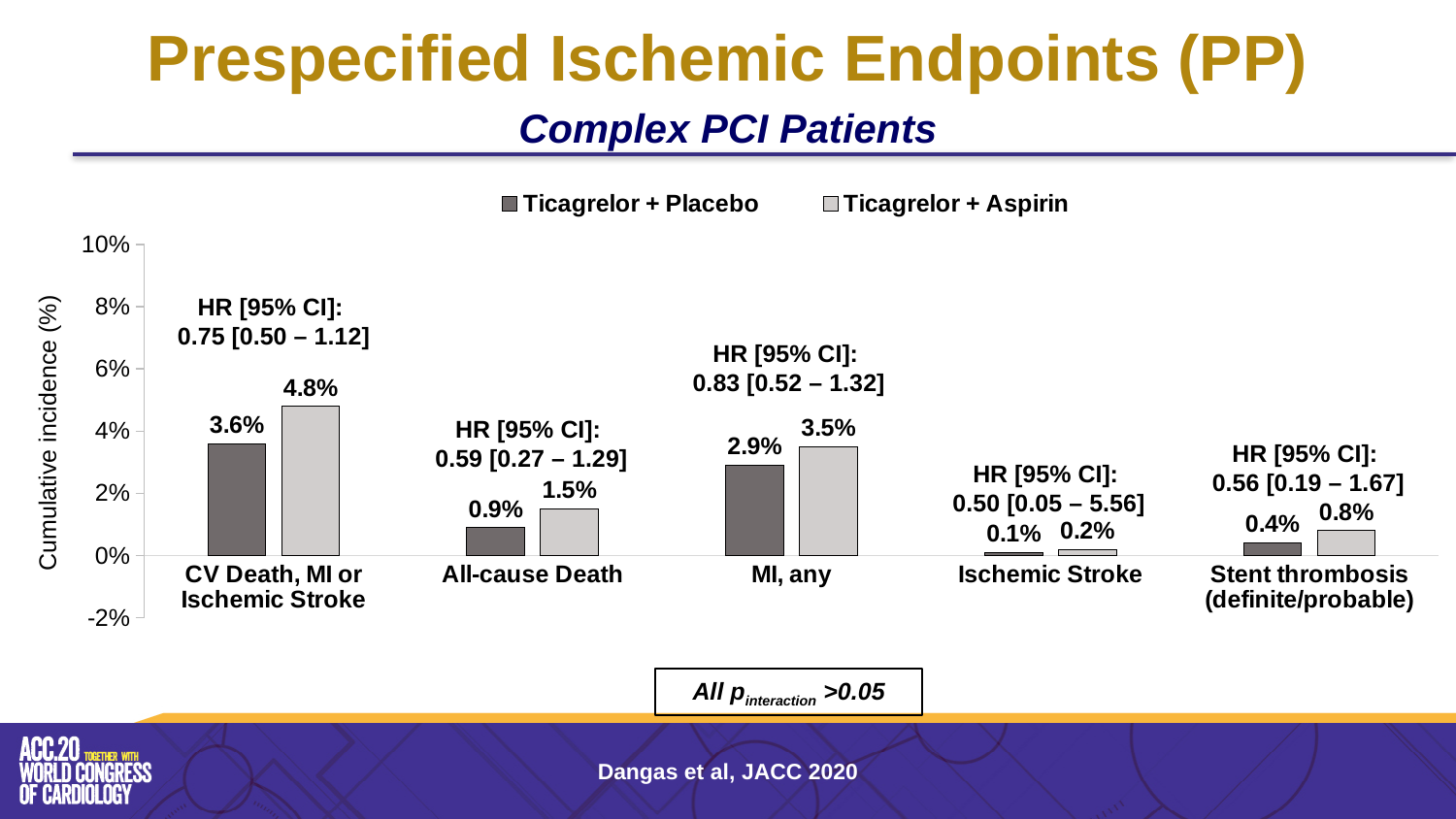
Which endpoint has the highest cumulative incidence for Ticagrelor + Placebo? CV Death, MI or Ischemic Stroke For MI, any, which series has the larger cumulative incidence? Ticagrelor + Aspirin What is the cumulative incidence of Stent thrombosis (definite/probable) for Ticagrelor + Placebo? 0.4% What is the cumulative incidence of All-cause Death for Ticagrelor + Placebo? 0.9% Is the Ticagrelor + Aspirin value for CV Death, MI or Ischemic Stroke greater or less than 4%? greater What is the cumulative incidence of CV Death, MI or Ischemic Stroke for Ticagrelor + Aspirin? 4.8% How many endpoint categories are shown on the x axis? 5 What kind of chart is shown on the slide? Bar chart What is the difference between the Ticagrelor + Aspirin and Ticagrelor + Placebo values for CV Death, MI or Ischemic Stroke? 1.2% What is the cumulative incidence of MI, any for Ticagrelor + Aspirin? 3.5% How many series does the legend list? 2 Which endpoint has the lowest cumulative incidence for Ticagrelor + Aspirin? Ischemic Stroke